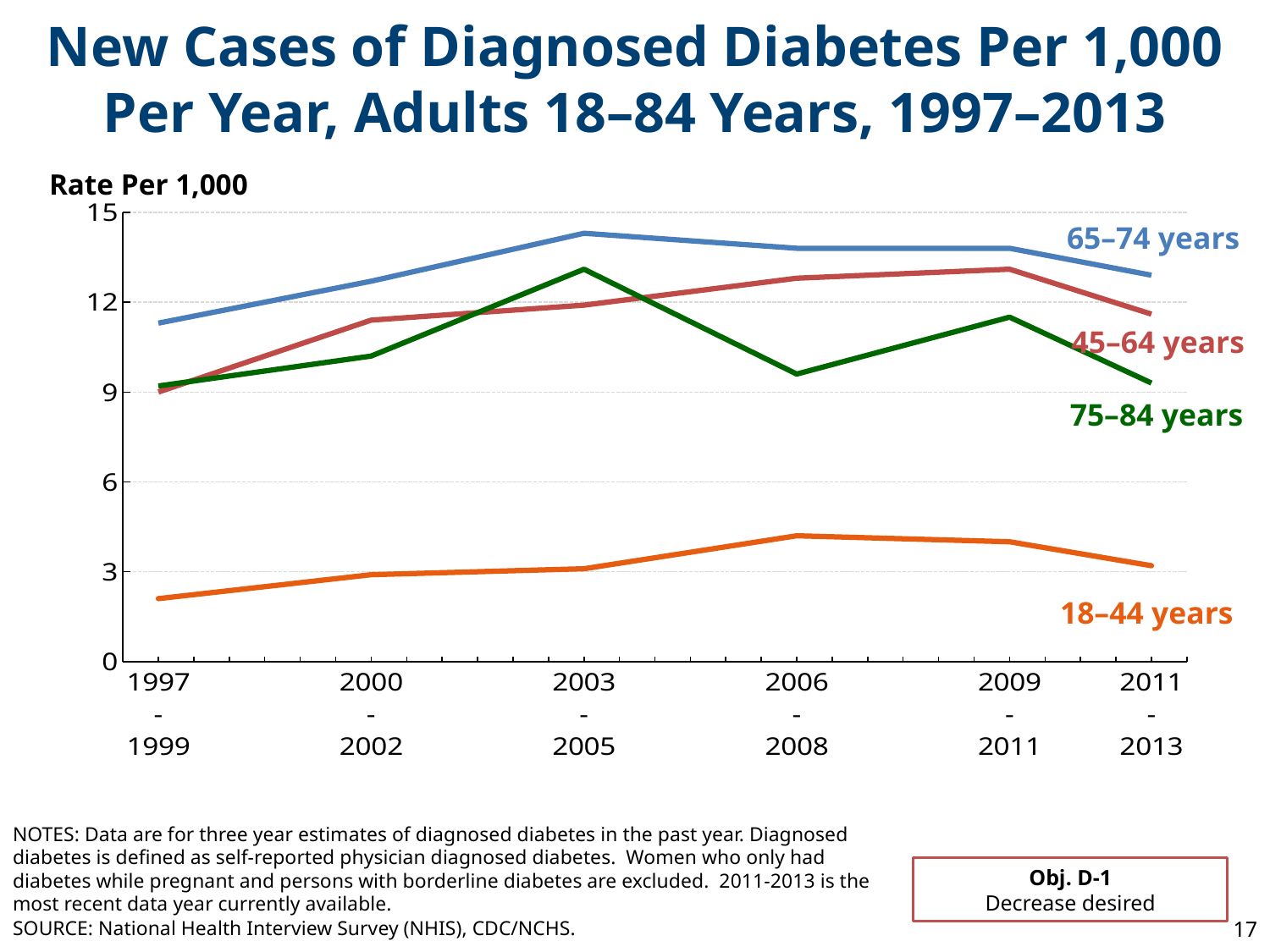
How many age groups are plotted as lines on the chart? 4 Is the value for 65–74 years in 2003-2005 greater or less than 12? greater Which age group has the highest rate in 2003-2005? 65–74 years Is the value for 65–74 years in 1997-1999 greater or less than 12? less How many time periods are shown along the x axis? 6 Which age group has the lowest rate in every period shown? 18–44 years Does the rate for 65–74 years rise or fall from 2003-2005 to 2011-2013? Fall What is the label on the y axis of the chart? Rate Per 1,000 Is the value for 18–44 years in 1997-1999 greater or less than 3? less What kind of chart is shown on the slide? Line chart In 2006-2008, which is larger: the rate for 45–64 years or for 75–84 years? 45–64 years